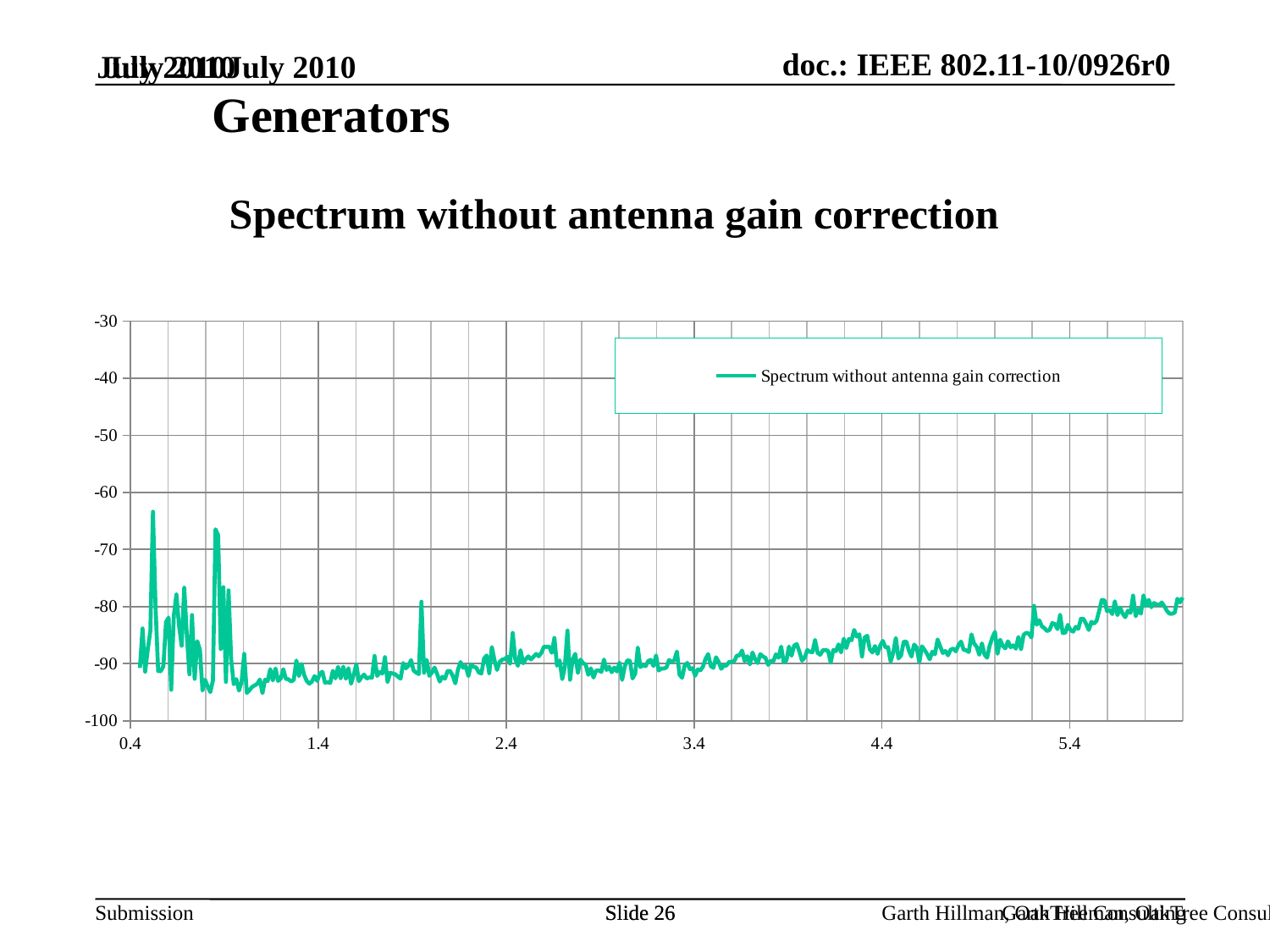
Is the lowest point of the line (between x = 1.0 and x = 1.4) greater or less than -90? less Is the value of the line at x = 4.4 greater or less than -80? less Is the highest peak of the line (near x = 0.5) greater or less than -70? greater What is the name of the series shown in the legend? Spectrum without antenna gain correction How many tick labels are shown on the x axis? 6 Between x = 3.4 and x = 5.4, do the values generally rise or fall? rise How many series does the legend list? 1 What is the title of the chart? Spectrum without antenna gain correction What is the lowest value labelled on the y axis? -100 What kind of chart is shown on the slide? line chart